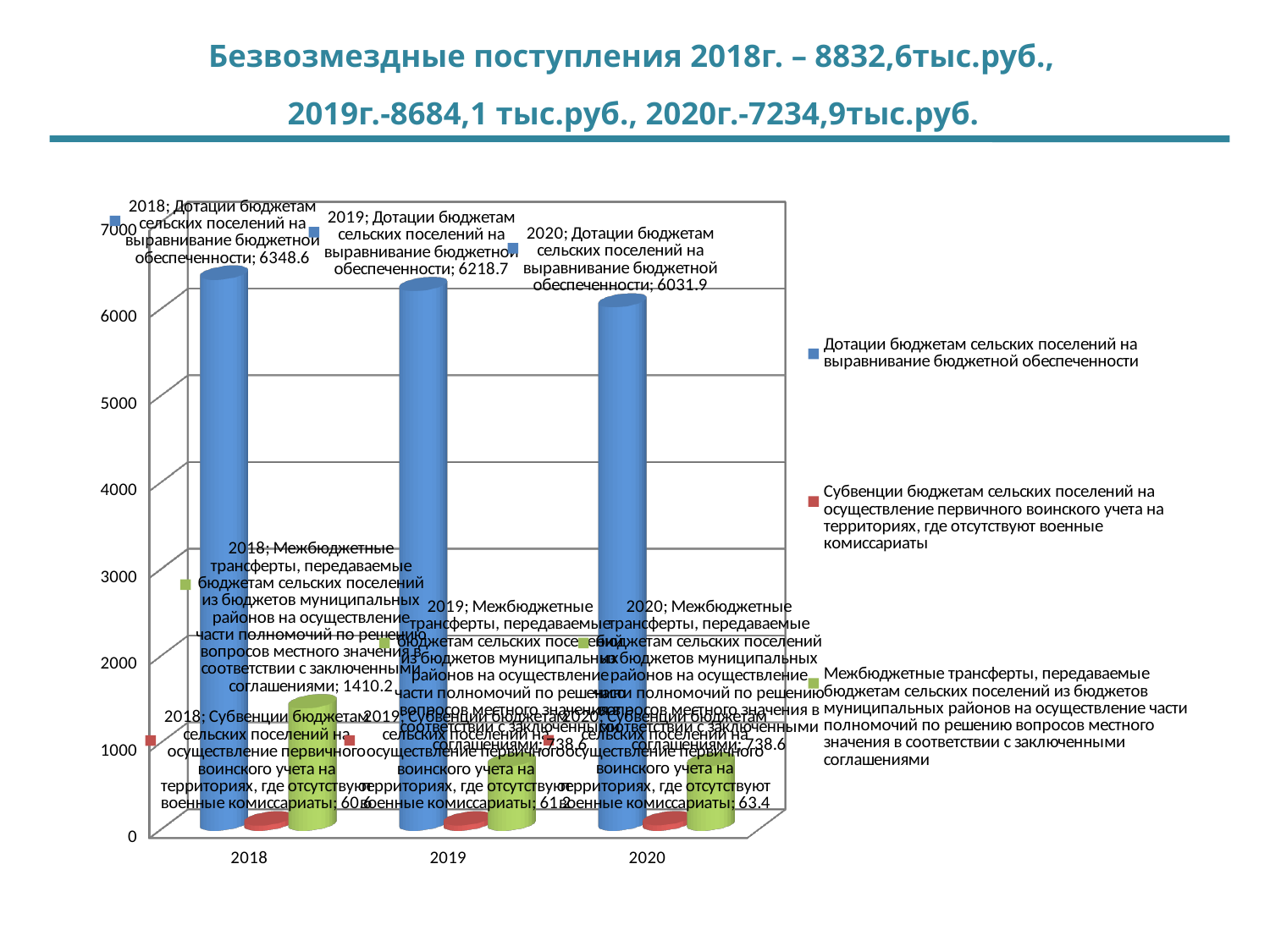
What is the value of Дотации бюджетам сельских поселений на выравнивание бюджетной обеспеченности for 2020? 6031.9 What is the difference between the Дотации values for 2018 and 2019? 129.9 Do the Дотации values rise or fall from 2018 to 2020? fall What kind of chart is shown on the slide? bar chart What is the difference between the Межбюджетные трансферты values for 2018 and 2019? 671.6 Which year has the larger Дотации value, 2019 or 2020? 2019 What is the value of Субвенции бюджетам сельских поселений for 2020? 63.4 In which year is the value of Дотации бюджетам сельских поселений the lowest? 2020 What is the value of Дотации бюджетам сельских поселений на выравнивание бюджетной обеспеченности for 2018? 6348.6 What is the value of Межбюджетные трансферты for 2018? 1410.2 In which year is the value of Дотации бюджетам сельских поселений the highest? 2018 How many series does the legend list? 3